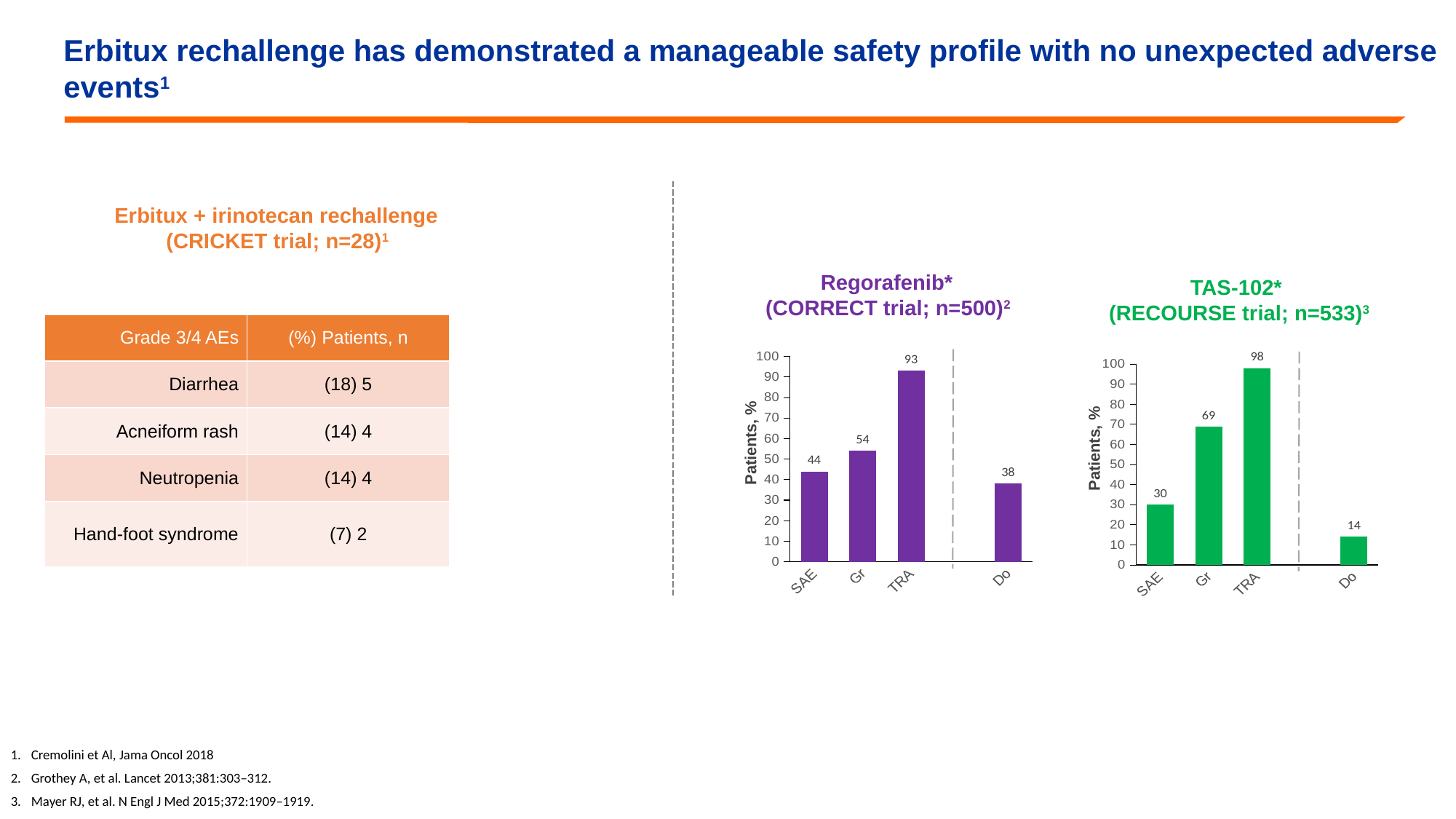
In the TAS-102 (RECOURSE trial) chart, which category has the lowest value? Do In the Regorafenib (CORRECT trial) chart, what is the value for TRA? 93 How many bars are plotted in the TAS-102 (RECOURSE trial) chart? 4 In the Regorafenib (CORRECT trial) chart, what is the value for SAE? 44 In the Regorafenib (CORRECT trial) chart, what is the difference between the values for TRA and SAE? 49 In the TAS-102 (RECOURSE trial) chart, what is the difference between the values for TRA and Gr? 29 In the Regorafenib (CORRECT trial) chart, which category has the highest value? TRA In the TAS-102 (RECOURSE trial) chart, what is the value for Do? 14 What is the y-axis label of the TAS-102 (RECOURSE trial) chart? Patients, % In the Regorafenib (CORRECT trial) chart, which is larger, the value for Gr or the value for Do? Gr In the TAS-102 (RECOURSE trial) chart, what is the value for Gr? 69 What kind of chart is the Regorafenib (CORRECT trial) chart? Bar chart